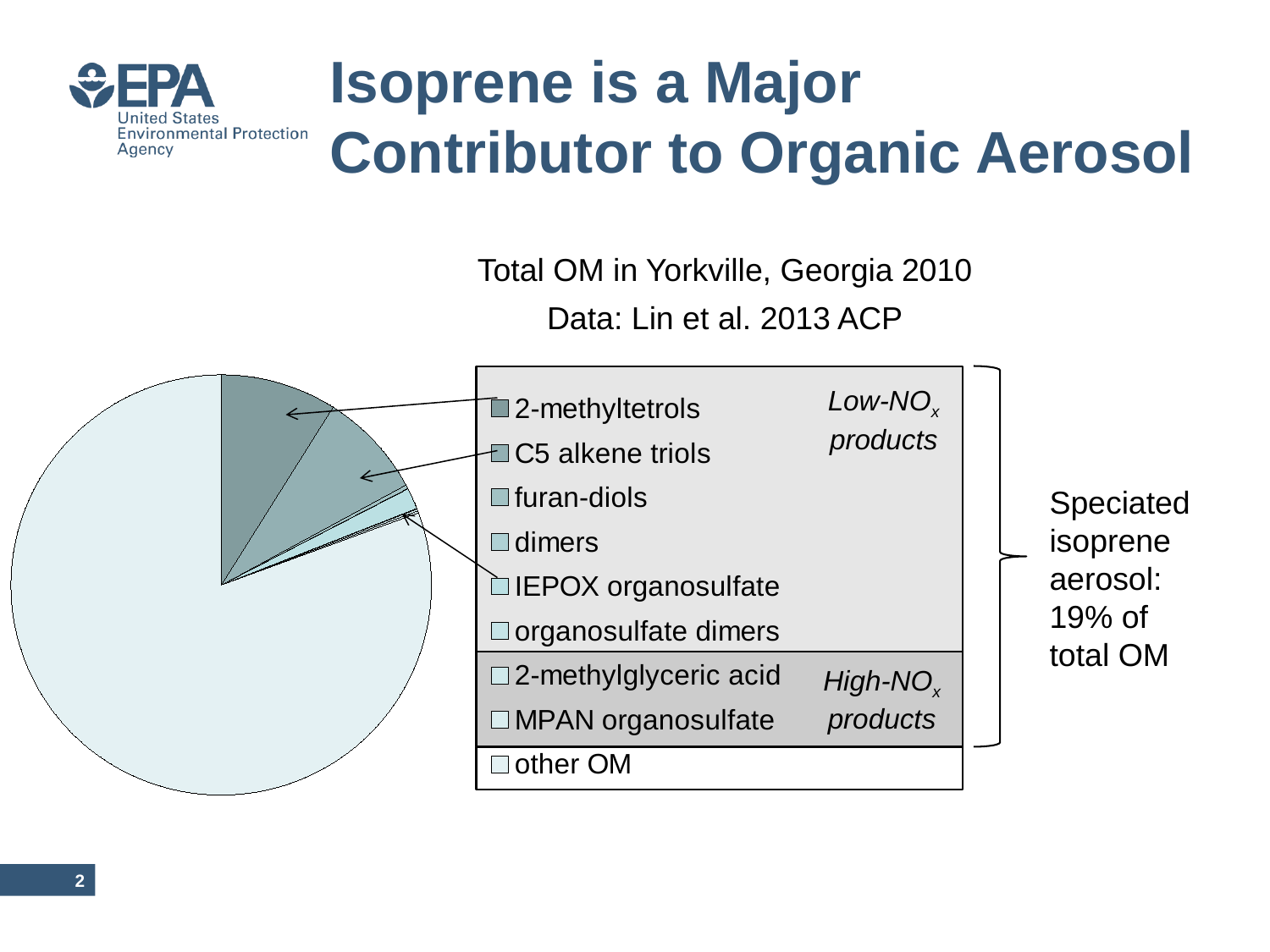
What kind of chart is shown on the slide? pie chart Which category takes up the largest slice of the pie? other OM What is the title of the chart? Total OM in Yorkville, Georgia 2010 Which legend entries are grouped as High-NOx products? 2-methylglyceric acid and MPAN organosulfate How many legend entries are grouped as Low-NOx products? 6 How many categories does the pie chart's legend list? 9 According to the annotation, what share of total OM is speciated isoprene aerosol? 19% What is the data source cited under the chart title? Lin et al. 2013 ACP Which is larger, the slice for 2-methyltetrols or the slice for MPAN organosulfate? 2-methyltetrols Which is larger, the slice for other OM or the slice for 2-methyltetrols? other OM